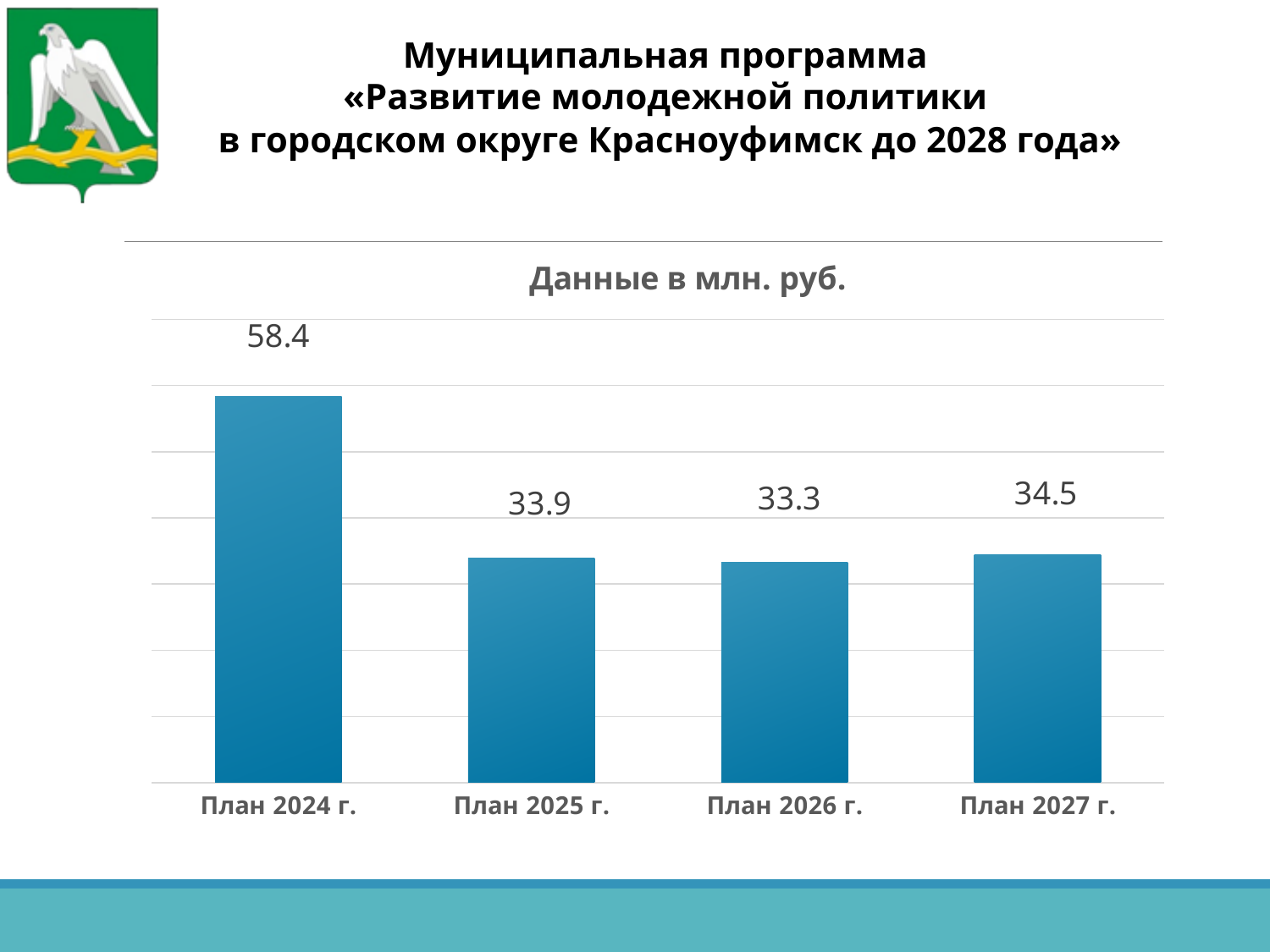
What is the difference between the values for План 2027 г. and План 2026 г.? 1.2 Which category has the lowest value? План 2026 г. What is the title of the chart? Данные в млн. руб. What is the value for План 2026 г.? 33.3 What is the difference between the values for План 2024 г. and План 2025 г.? 24.5 What kind of chart is shown on the slide? bar chart Which is larger, the value for План 2025 г. or the value for План 2027 г.? План 2027 г. How many categories are shown on the chart? 4 What is the value for План 2025 г.? 33.9 What is the value for План 2024 г.? 58.4 Which category has the highest value? План 2024 г. What is the value for План 2027 г.? 34.5